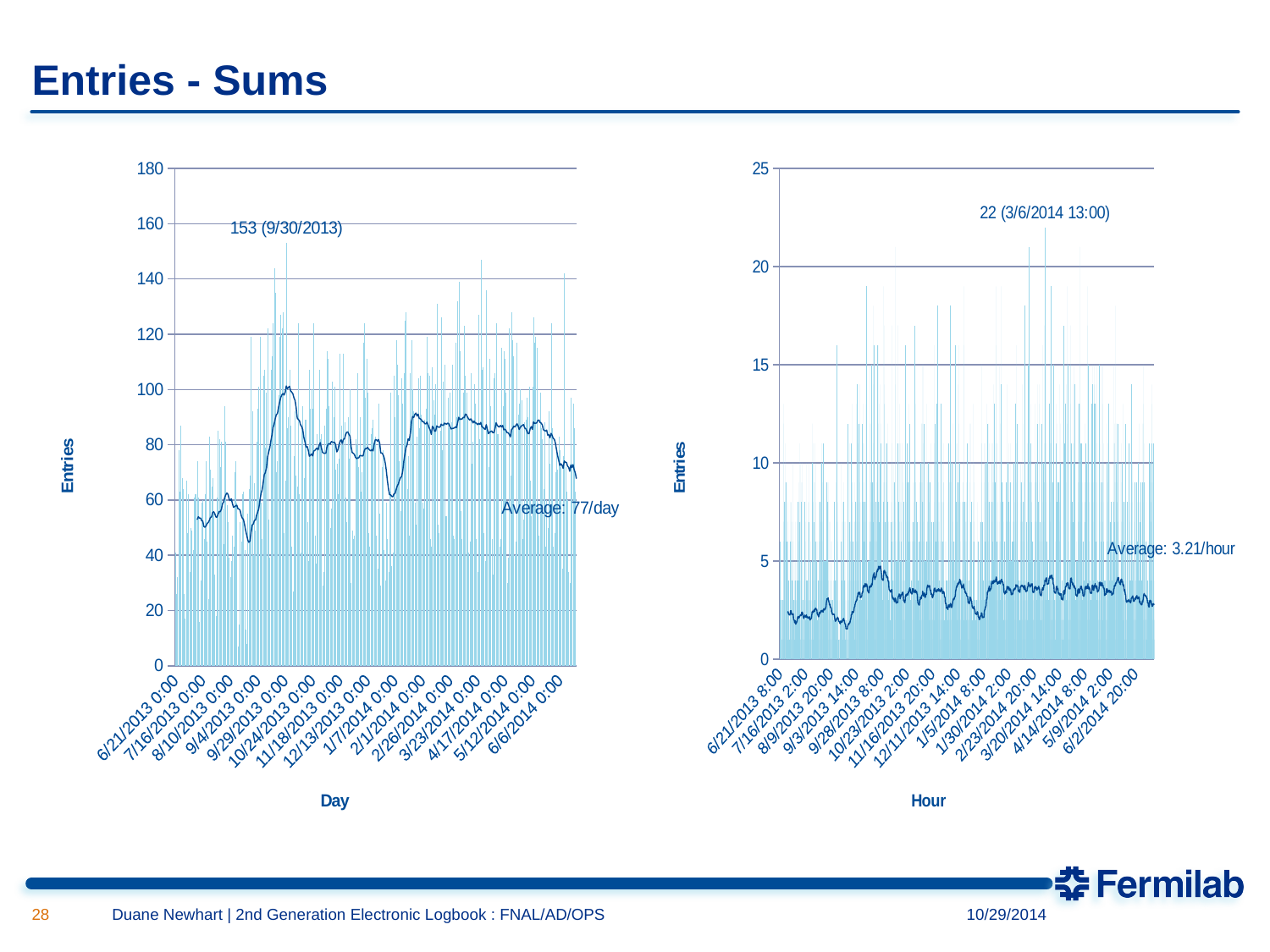
On the left chart (Day), is the peak value of 153 greater or less than 140? greater On the left chart (Day), what is the maximum daily entry count annotated on the chart? 153 On the right chart (Hour), what is the maximum hourly entry count annotated on the chart? 22 What is the highest tick value on the y axis of the right chart (Hour)? 25 On the left chart (Day), what is the difference between the peak value of 153 and the average of 77? 76 Which chart has the higher annotated average, the left chart (Day) or the right chart (Hour)? the left chart (Day) What is the label on the y axis of the left chart (Day)? Entries On the left chart (Day), on what date did the peak of 153 entries occur? 9/30/2013 On the right chart (Hour), is the peak value of 22 greater or less than 20? greater On the right chart (Hour), what average is annotated on the chart? 3.21/hour On the right chart (Hour), when did the peak of 22 entries occur? 3/6/2014 13:00 On the left chart (Day), what average is annotated on the chart? 77/day